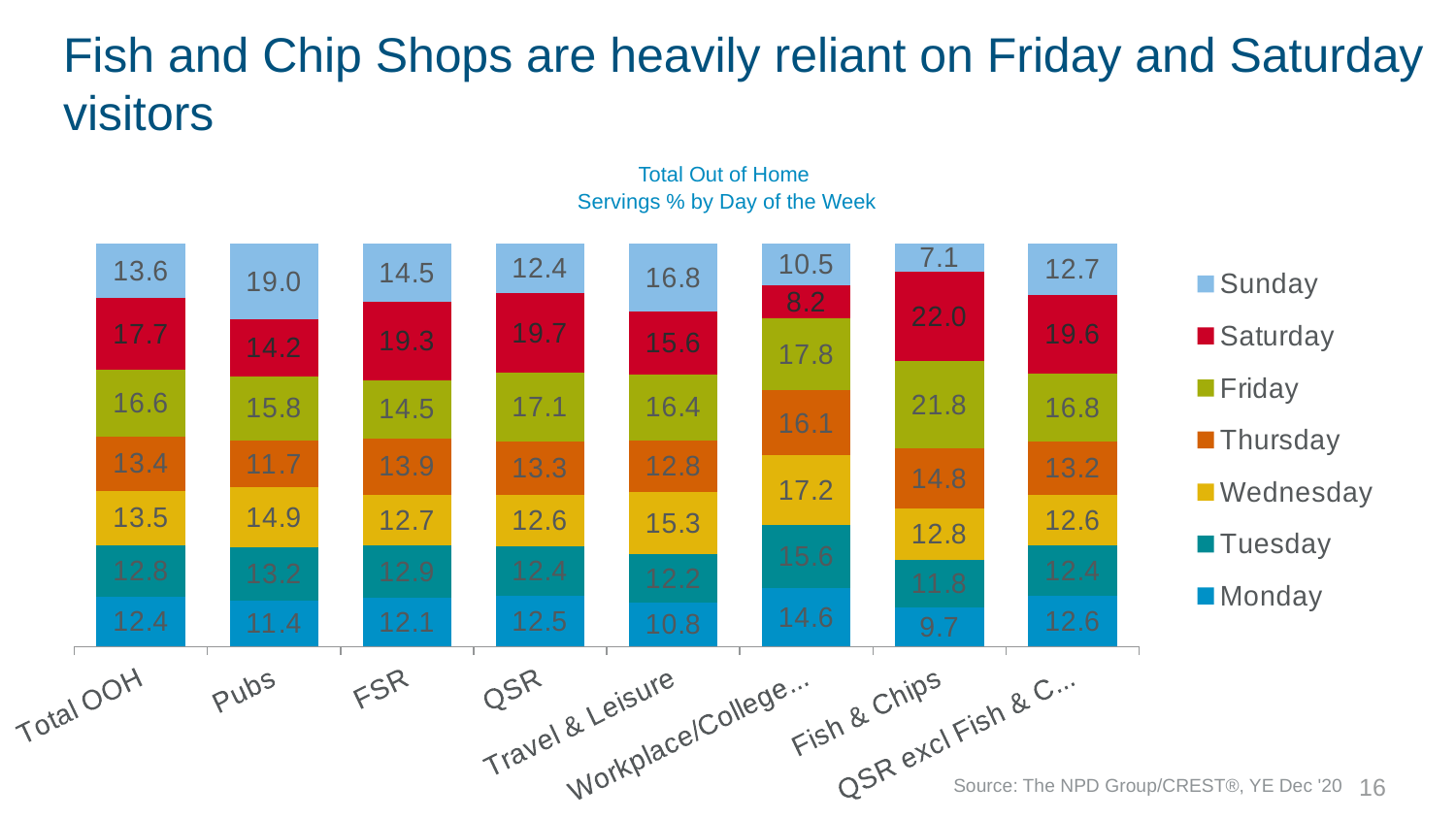
What is the title of the chart? Total Out of Home Servings % by Day of the Week What type of chart is shown on the slide? Stacked bar chart What is the Saturday value for Fish & Chips? 22.0 Which category has the highest Saturday value? Fish & Chips Which category has the lowest Sunday value? Fish & Chips What is the difference between the Friday value for Fish & Chips and the Friday value for Total OOH? 5.2 What is the total of the stacked bar for Fish & Chips? 100.0 What is the Sunday value for Pubs? 19.0 Which is larger, the Saturday value for QSR or the Saturday value for FSR? QSR What is the Monday value for Travel & Leisure? 10.8 How many categories are shown along the x axis? 8 How many series does the legend list? 7